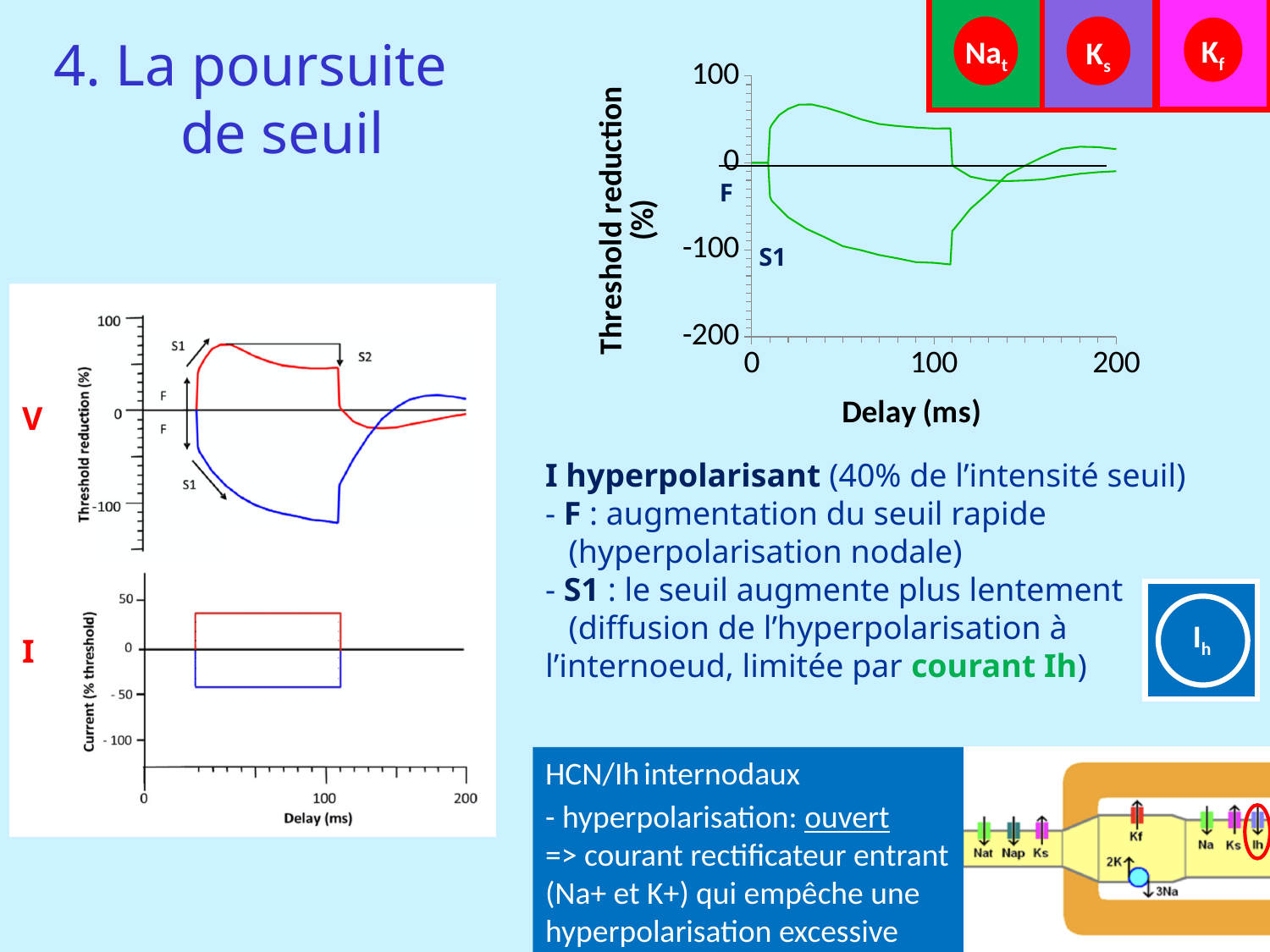
On the 'Threshold reduction (%)' chart, what is the lowest value shown on the y axis? -200 On the 'Threshold reduction (%)' chart, is the value of the lower curve (labelled S1) at a delay of 50 ms greater or less than 0? less On the 'Threshold reduction (%)' chart, what is the title of the x axis? Delay (ms) On the 'Threshold reduction (%)' chart, does the lower curve (labelled S1) rise or fall between a delay of 20 ms and 100 ms? fall On the 'Threshold reduction (%)' chart, what is the largest value shown on the x axis? 200 On the 'Threshold reduction (%)' chart, is the value of the lower curve (labelled S1) at a delay of 100 ms greater or less than -100? less What kind of chart is the 'Threshold reduction (%)' chart on the right of the slide? line chart On the 'Threshold reduction (%)' chart, is the value of the upper curve at a delay of 50 ms greater or less than 0? greater On the 'Threshold reduction (%)' chart, at a delay of 50 ms, which curve has the larger value: the upper curve or the lower curve labelled S1? the upper curve